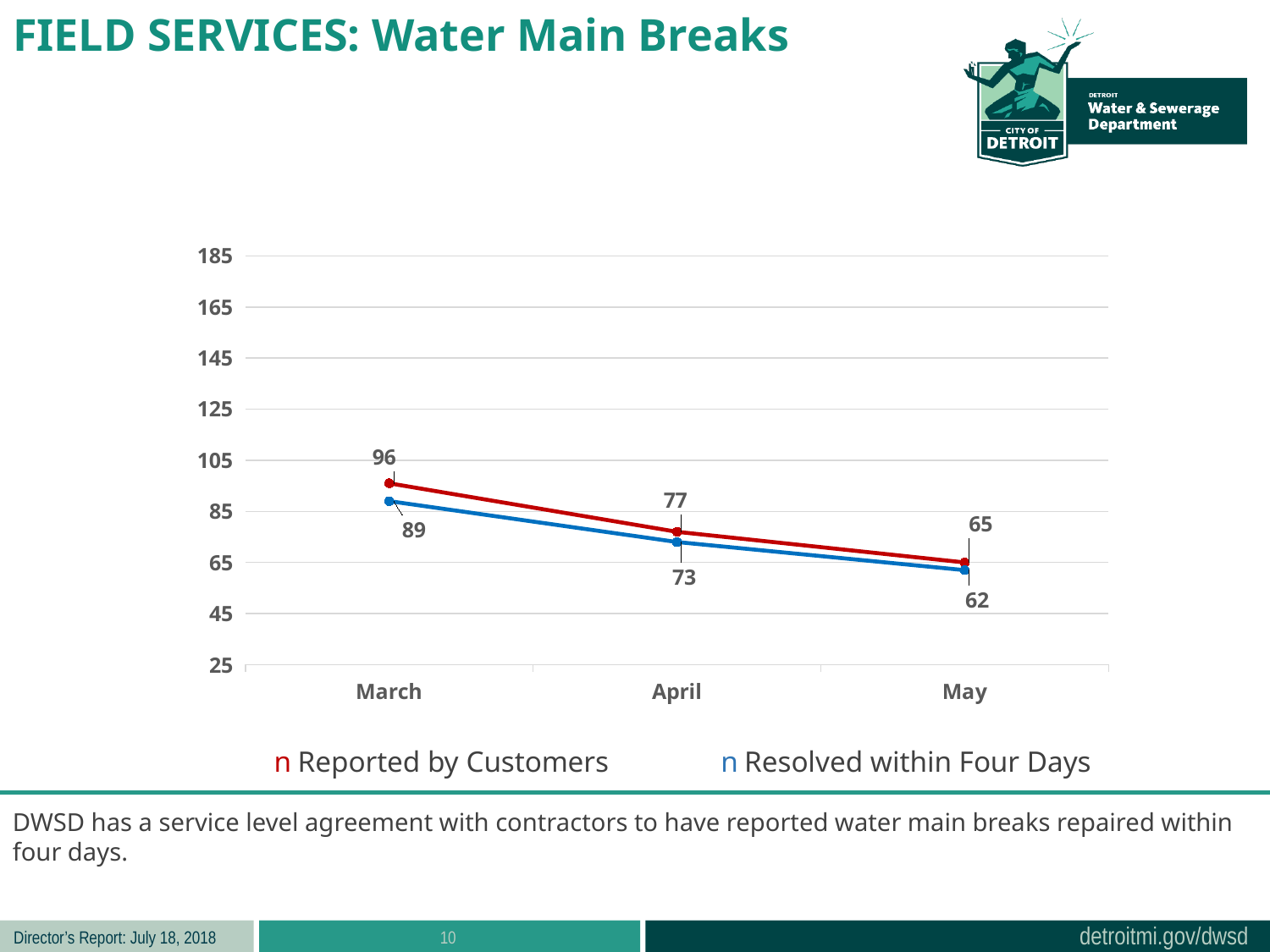
In which month was the number of breaks reported by customers highest? March Is the value for Resolved within Four Days in May greater or less than 65? less How many months are shown on the x axis? 3 How many water main breaks were resolved within four days in April? 73 How many water main breaks were reported by customers in March? 96 What is the difference between breaks reported by customers and breaks resolved within four days in March? 7 What is the value for Reported by Customers in May? 65 How many series does the legend list? 2 Which is larger in April: breaks reported by customers or breaks resolved within four days? Reported by Customers In which month was the number of breaks resolved within four days lowest? May What kind of chart is shown on the slide? line chart Do the values for Reported by Customers rise or fall from March to May? fall